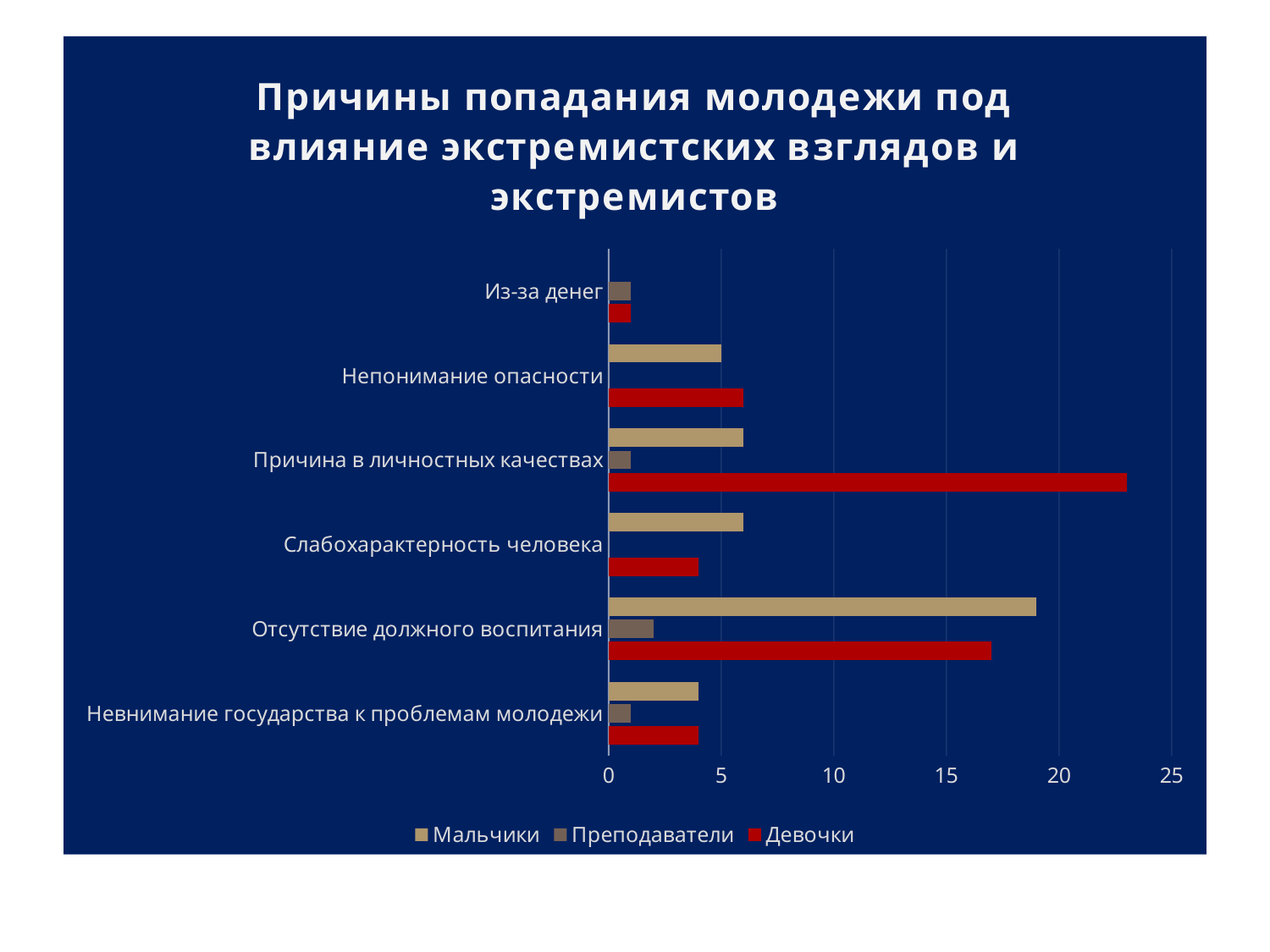
For which category is the Мальчики value highest? Отсутствие должного воспитания What kind of chart is shown on the slide? bar chart Is the Девочки value for Слабохарактерность человека greater or less than 5? less Which series is shown in red in the legend? Девочки What is the title of the chart? Причины попадания молодежи под влияние экстремистских взглядов и экстремистов In the category Причина в личностных качествах, which is larger: the Девочки value or the Мальчики value? Девочки Is the Мальчики value for Отсутствие должного воспитания greater or less than 15? greater For which category is the Девочки value highest? Причина в личностных качествах What is the value for Мальчики in the category Непонимание опасности? 5 How many categories are shown on the chart? 6 How many series does the legend list? 3 Is the Девочки value for Причина в личностных качествах greater or less than 20? greater